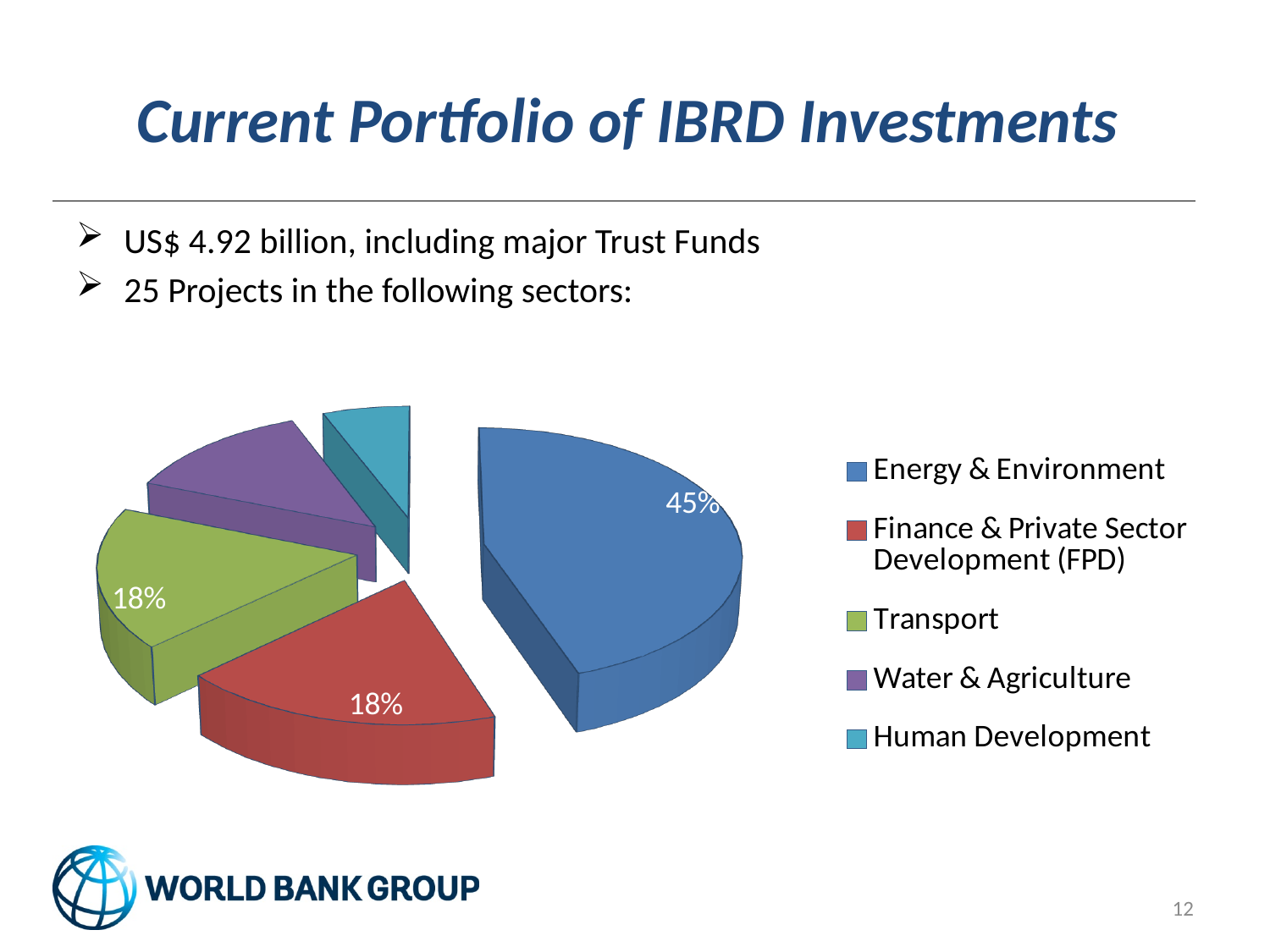
What is the difference in percentage points between the Energy & Environment share and the Transport share? 27 What share of the portfolio is Transport? 18% How many entries does the legend list? 5 What kind of chart is shown on the slide? pie chart How many slices does the pie chart have? 5 What share of the portfolio is Finance & Private Sector Development (FPD)? 18% What colour is the Transport slice in the pie chart? green What share of the portfolio is Energy & Environment? 45% Which sector has the largest share of the pie? Energy & Environment Which is larger, the slice for Water & Agriculture or the slice for Human Development? Water & Agriculture Which is larger, the share for Energy & Environment or the share for Transport? Energy & Environment Which sector has the smallest share of the pie? Human Development